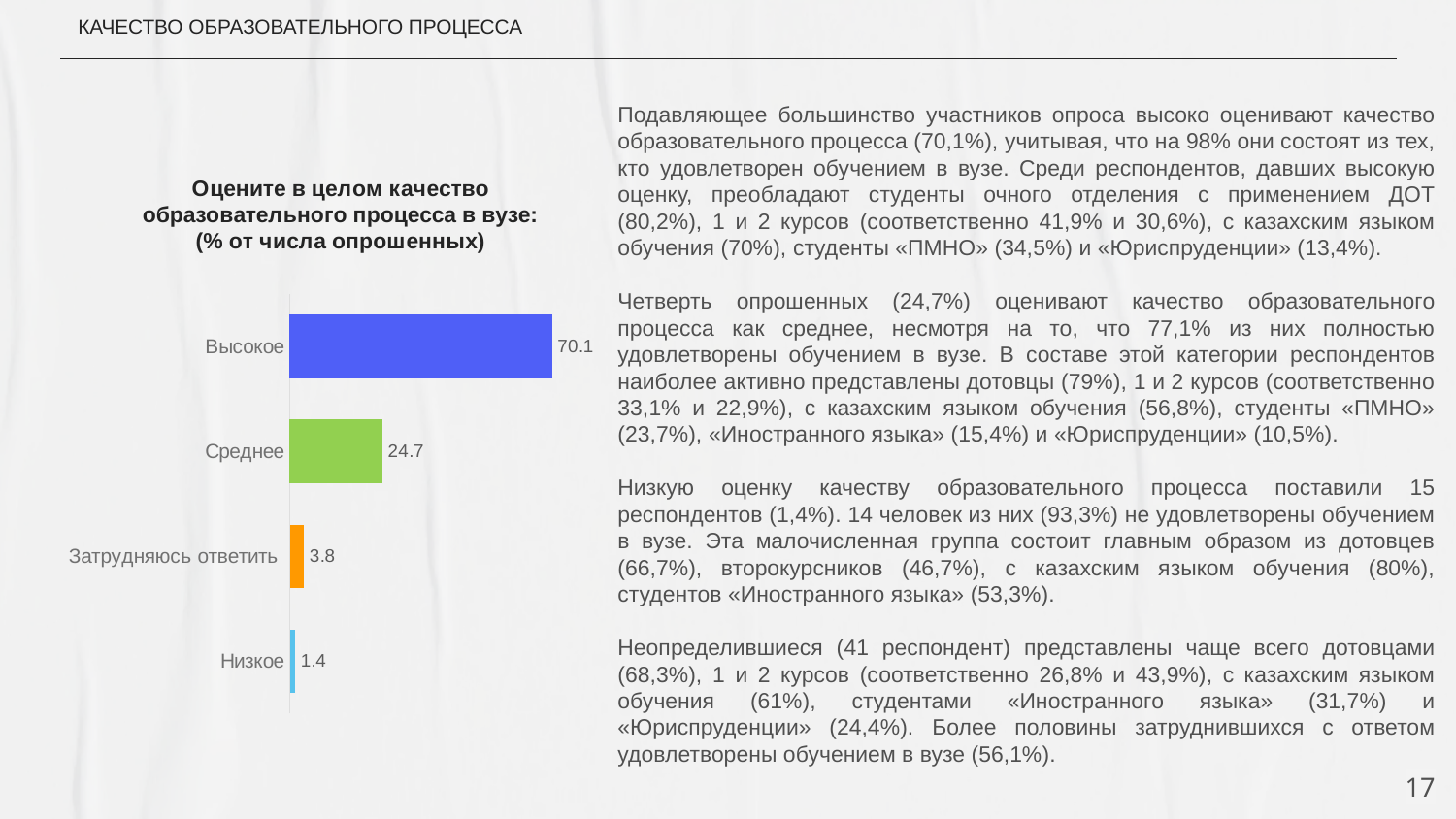
Which category has the highest value in the chart? Высокое Which category has the lowest value in the chart? Низкое What is the value for «Затрудняюсь ответить» in the chart? 3.8 Which is larger, the value for «Среднее» or the value for «Затрудняюсь ответить»? Среднее What is the difference between the values for «Затрудняюсь ответить» and «Низкое»? 2.4 What is the value for «Среднее» in the chart? 24.7 How many categories are shown in the chart? 4 What colour is the bar for «Среднее»? Green What is the value for «Высокое» in the chart? 70.1 What kind of chart is shown on the slide? Bar chart What is the difference between the values for «Высокое» and «Среднее»? 45.4 What is the value for «Низкое» in the chart? 1.4